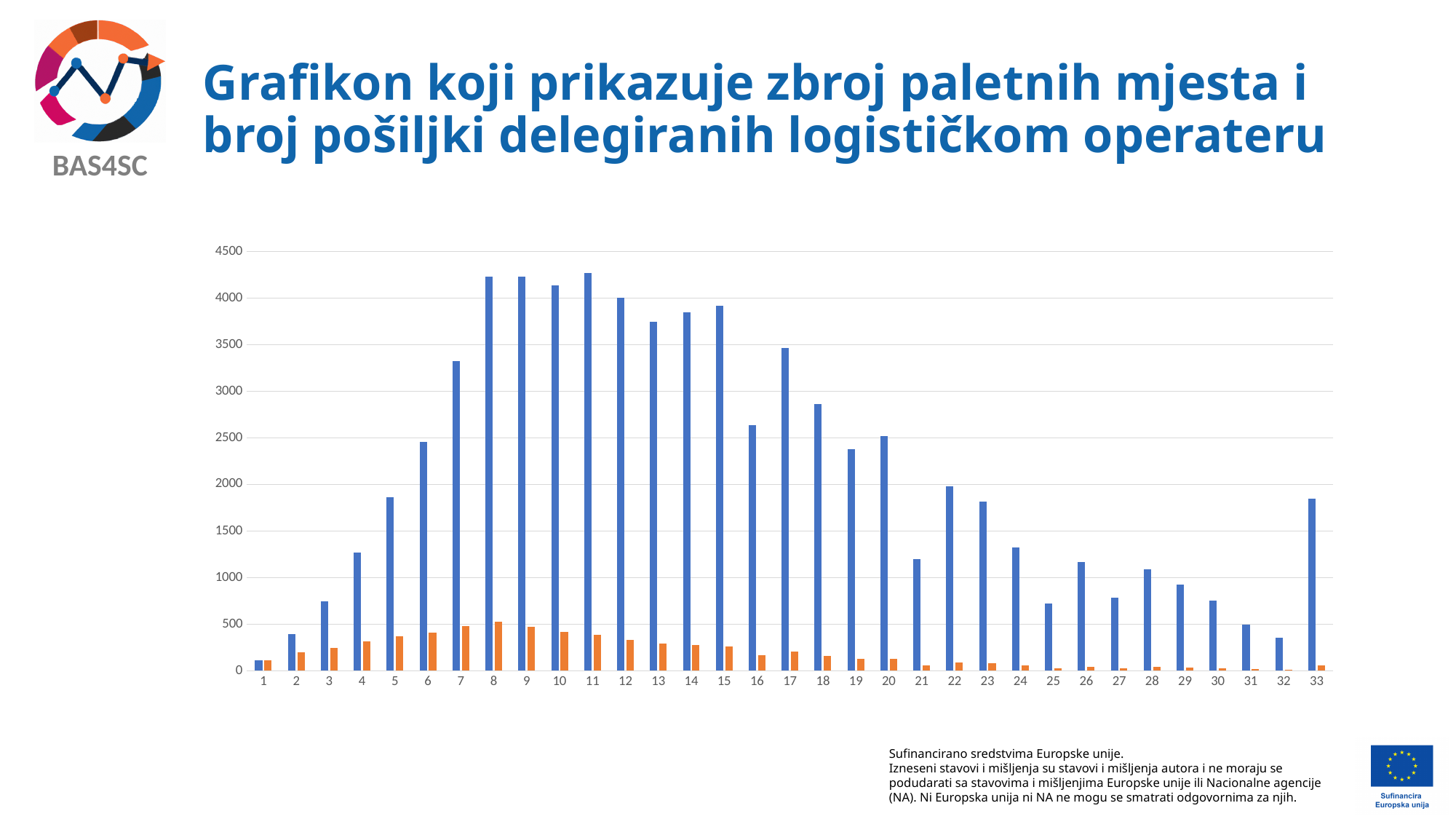
How many categories are shown along the x axis of the chart? 33 What kind of chart is shown on the slide? bar chart Which is larger, the blue bar for category 17 or the blue bar for category 18? category 17 Do the blue bars generally rise or fall from category 1 to category 8? rise Which is larger, the blue bar for category 21 or the blue bar for category 22? category 22 Which category has the lowest blue bar? 1 Is the blue bar for category 7 greater or less than 3000? greater Which category has the highest orange bar? 8 Is the blue bar for category 8 greater or less than 4000? greater Is the blue bar for category 1 greater or less than 500? less